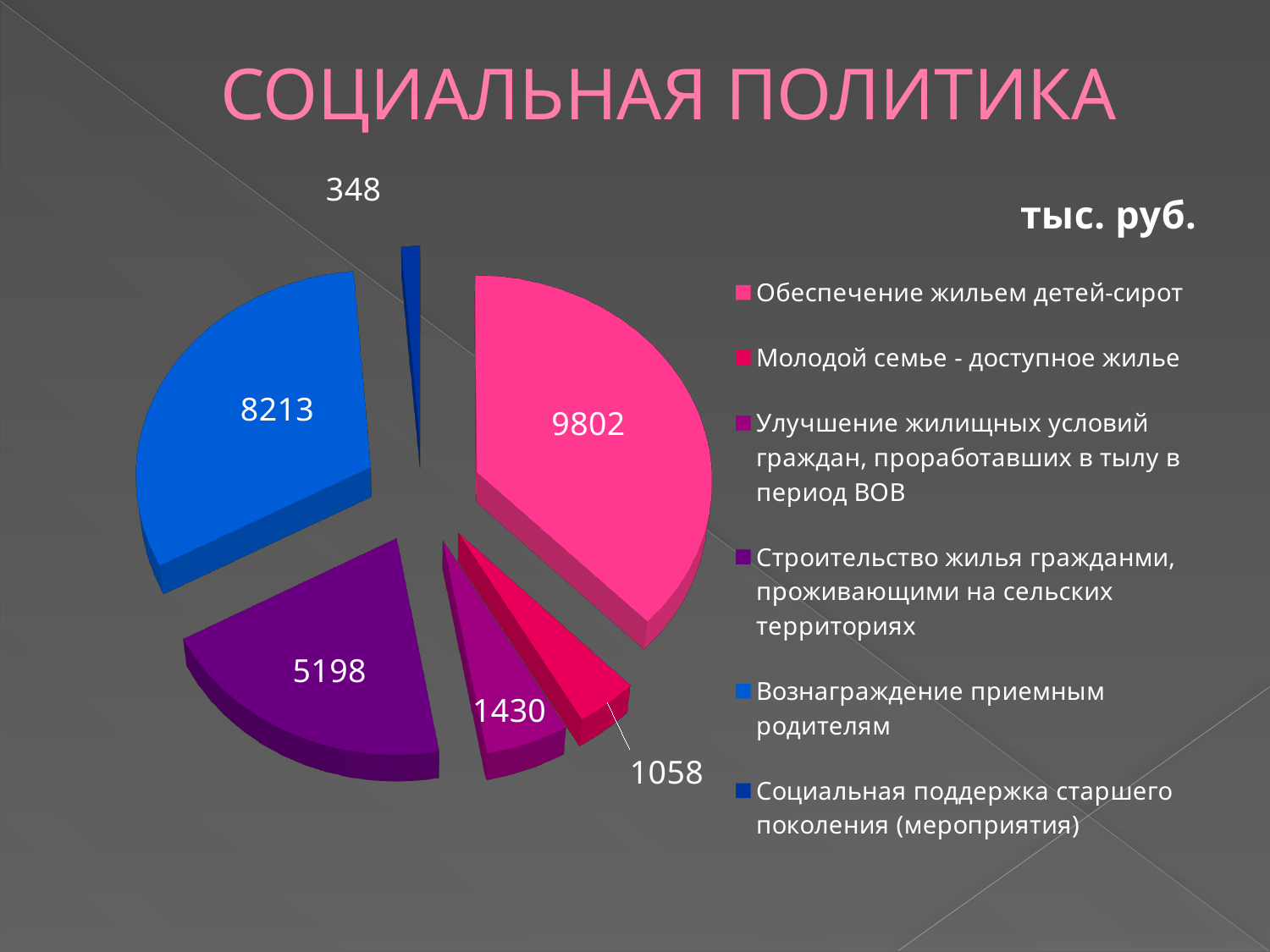
How many categories does the pie chart have? 6 What kind of chart is shown on the slide? pie chart What is the value for Обеспечение жильем детей-сирот? 9802 Which category has the smallest slice of the pie? Социальная поддержка старшего поколения (мероприятия) What is the value for Строительство жилья гражданми, проживающими на сельских территориях? 5198 What is the value for Молодой семье - доступное жилье? 1058 What unit is indicated for the values in the chart? тыс. руб. What is the value for Социальная поддержка старшего поколения (мероприятия)? 348 Which category has the largest slice of the pie? Обеспечение жильем детей-сирот What is the value for Вознаграждение приемным родителям? 8213 Which is larger: the value for Улучшение жилищных условий граждан, проработавших в тылу в период ВОВ or the value for Молодой семье - доступное жилье? Улучшение жилищных условий граждан, проработавших в тылу в период ВОВ What is the difference between the values for Обеспечение жильем детей-сирот and Вознаграждение приемным родителям? 1589